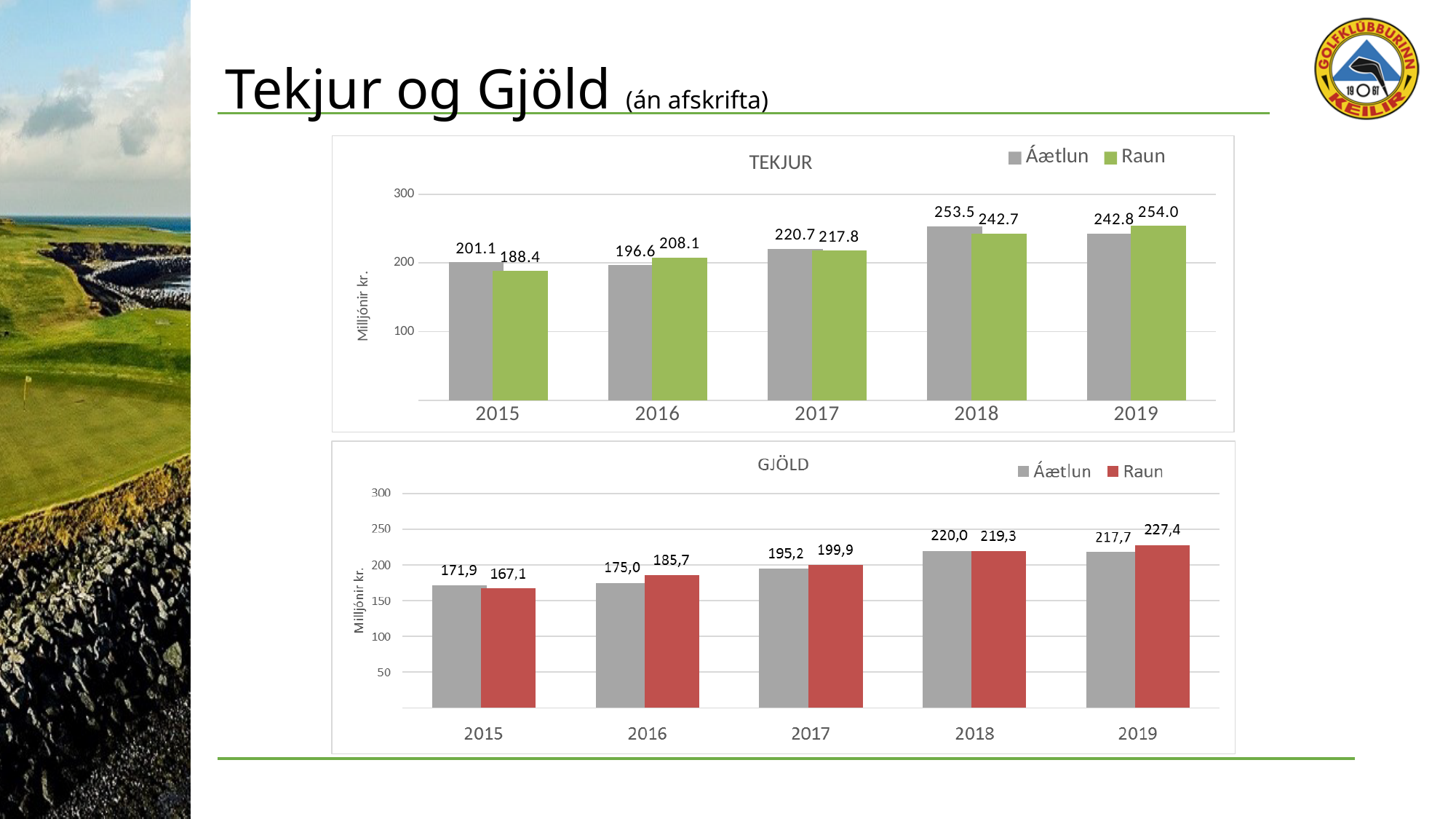
In the GJÖLD chart, how much higher is Raun than Áætlun in 2019? 9,7 In the GJÖLD chart, how many years are shown on the x axis? 5 In the GJÖLD chart, do the Raun values rise or fall from 2015 to 2019? rise In the TEKJUR chart, which is larger for 2016, Áætlun or Raun? Raun In the TEKJUR chart, what is the Áætlun value for 2017? 220.7 In the GJÖLD chart, which year has the lowest Raun value? 2015 In the TEKJUR chart, which year has the highest Raun value? 2019 What type of chart is the GJÖLD chart? bar chart In the TEKJUR chart, what is the Raun value for 2019? 254.0 In the TEKJUR chart, how many series does the legend list? 2 In the GJÖLD chart, what is the Áætlun value for 2018? 220,0 In the TEKJUR chart, how much higher is Áætlun than Raun in 2018? 10.8